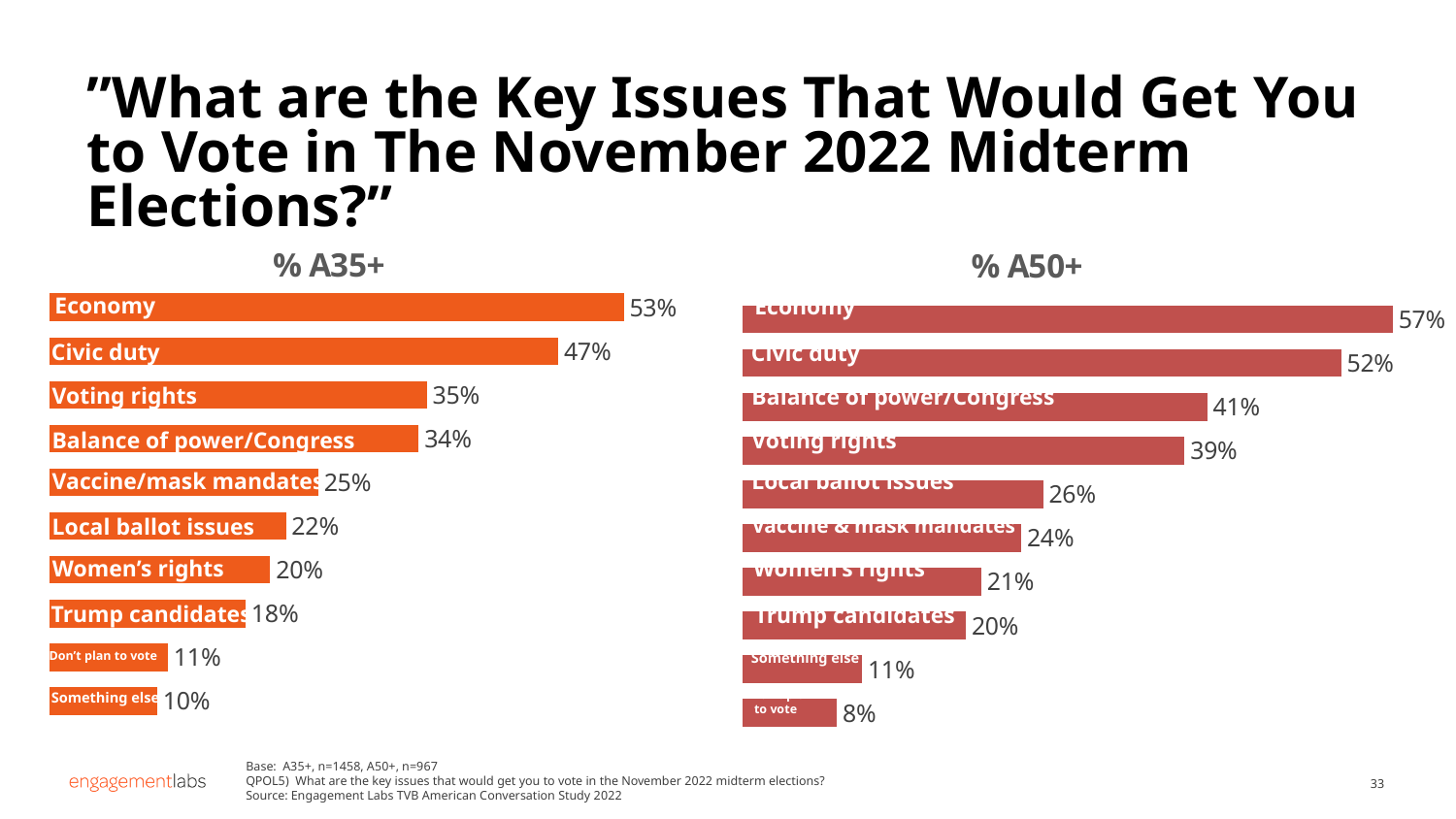
In the % A50+ chart, what is the difference between Balance of power/Congress and Voting rights? 2% How many categories are shown in the % A35+ chart? 10 In the % A35+ chart, what is the value for Balance of power/Congress? 34% What type of chart is the % A50+ chart? Bar chart In the % A50+ chart, what is the value for Civic duty? 52% In the % A50+ chart, which category has the highest value? Economy In the % A35+ chart, which category has the highest value? Economy In the % A50+ chart, what is the value for Voting rights? 39% Which is larger: Women's rights in the % A35+ chart or Women's rights in the % A50+ chart? % A50+ (21%) In the % A35+ chart, what is the difference between Economy and Civic duty? 6% In the % A35+ chart, what is the value for Economy? 53% In the % A35+ chart, which category has the lowest value? Something else